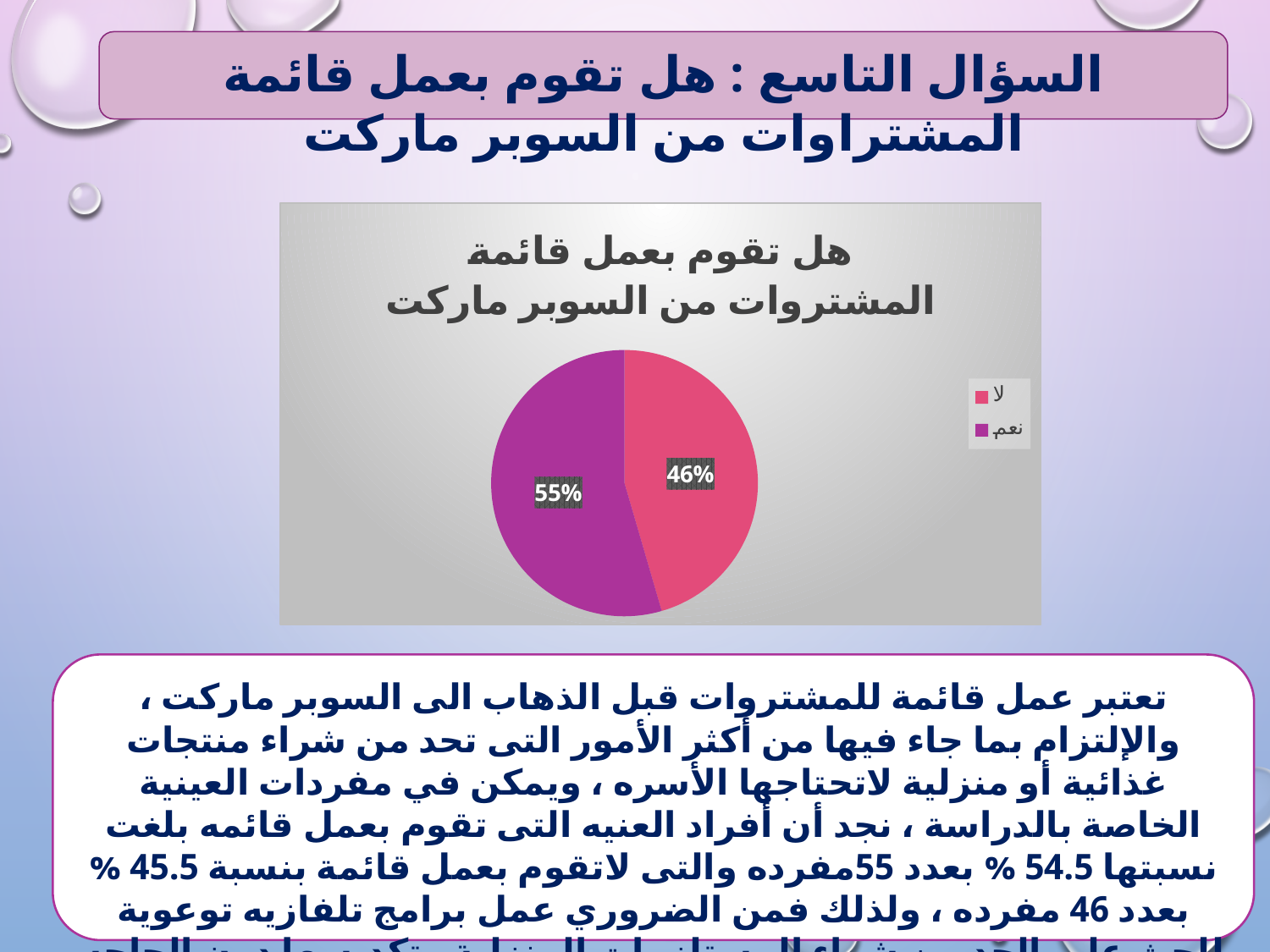
What is the value shown for the "لا" slice? 46% What colour is the "لا" slice in the pie chart? pink How many entries does the legend list? 2 Which category has the smallest slice of the pie? لا What type of chart is shown on the slide? pie chart Which is larger, the "نعم" slice or the "لا" slice? نعم How many slices does the pie chart have? 2 What is the difference between the "نعم" and "لا" percentages shown on the chart? 9% Which category has the largest slice of the pie? نعم What is the value shown for the "نعم" slice? 55% What is the title of the chart? هل تقوم بعمل قائمة المشتروات من السوبر ماركت